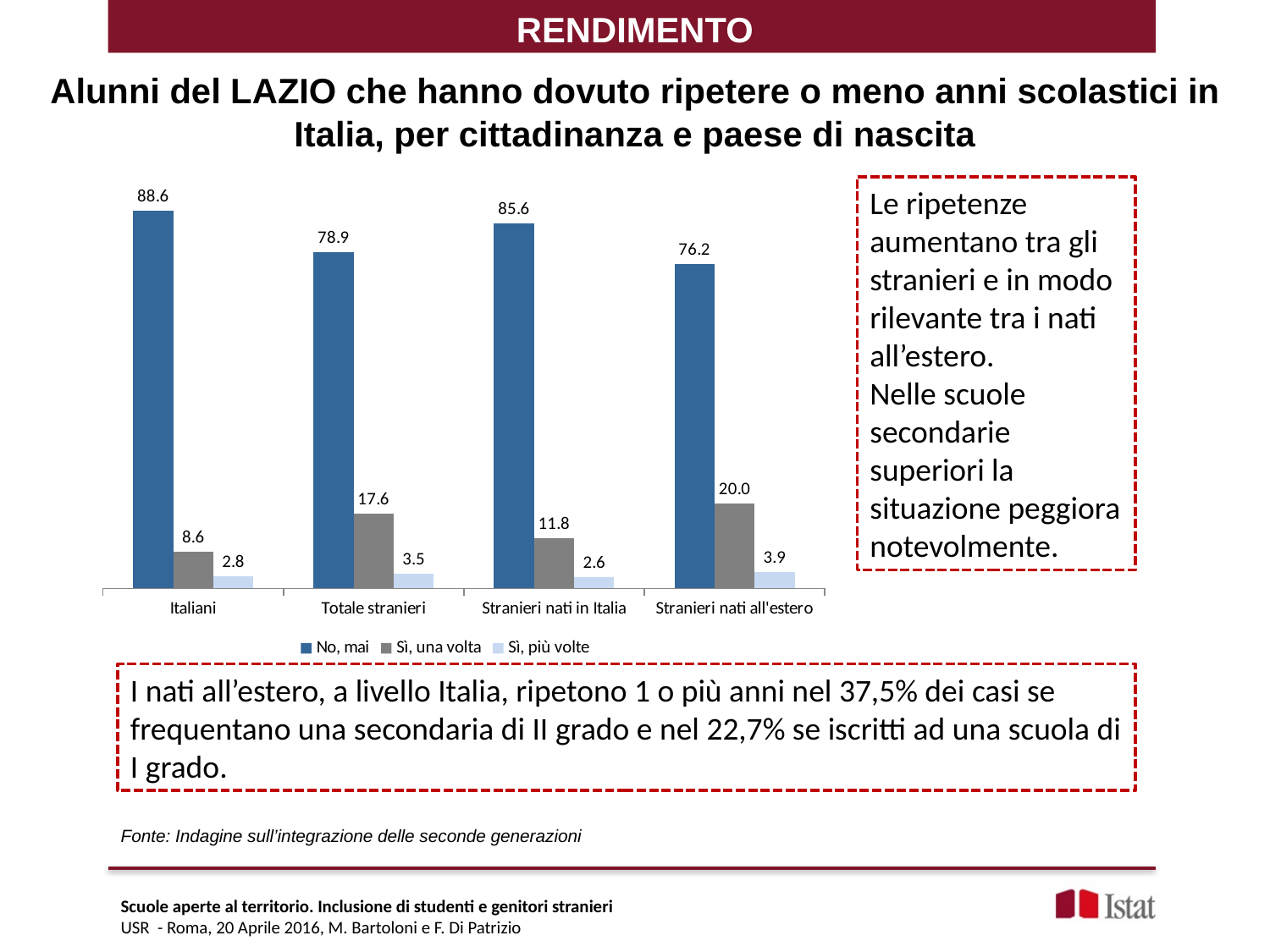
What kind of chart is shown on the slide? Bar chart What is the value of "Sì, una volta" for Stranieri nati in Italia? 11.8 What is the difference between the "No, mai" values for Italiani and Stranieri nati all'estero? 12.4 Which category has the lowest value for "No, mai"? Stranieri nati all'estero Which legend entry corresponds to the dark blue bars? No, mai Which category has the highest value for "Sì, una volta"? Stranieri nati all'estero How many categories are shown on the x axis? 4 What is the value of "Sì, una volta" for Stranieri nati all'estero? 20.0 How many series does the legend list? 3 What is the value of "No, mai" for Italiani? 88.6 What is the value of "Sì, più volte" for Totale stranieri? 3.5 Which is larger: "Sì, una volta" for Totale stranieri or for Stranieri nati in Italia? Totale stranieri